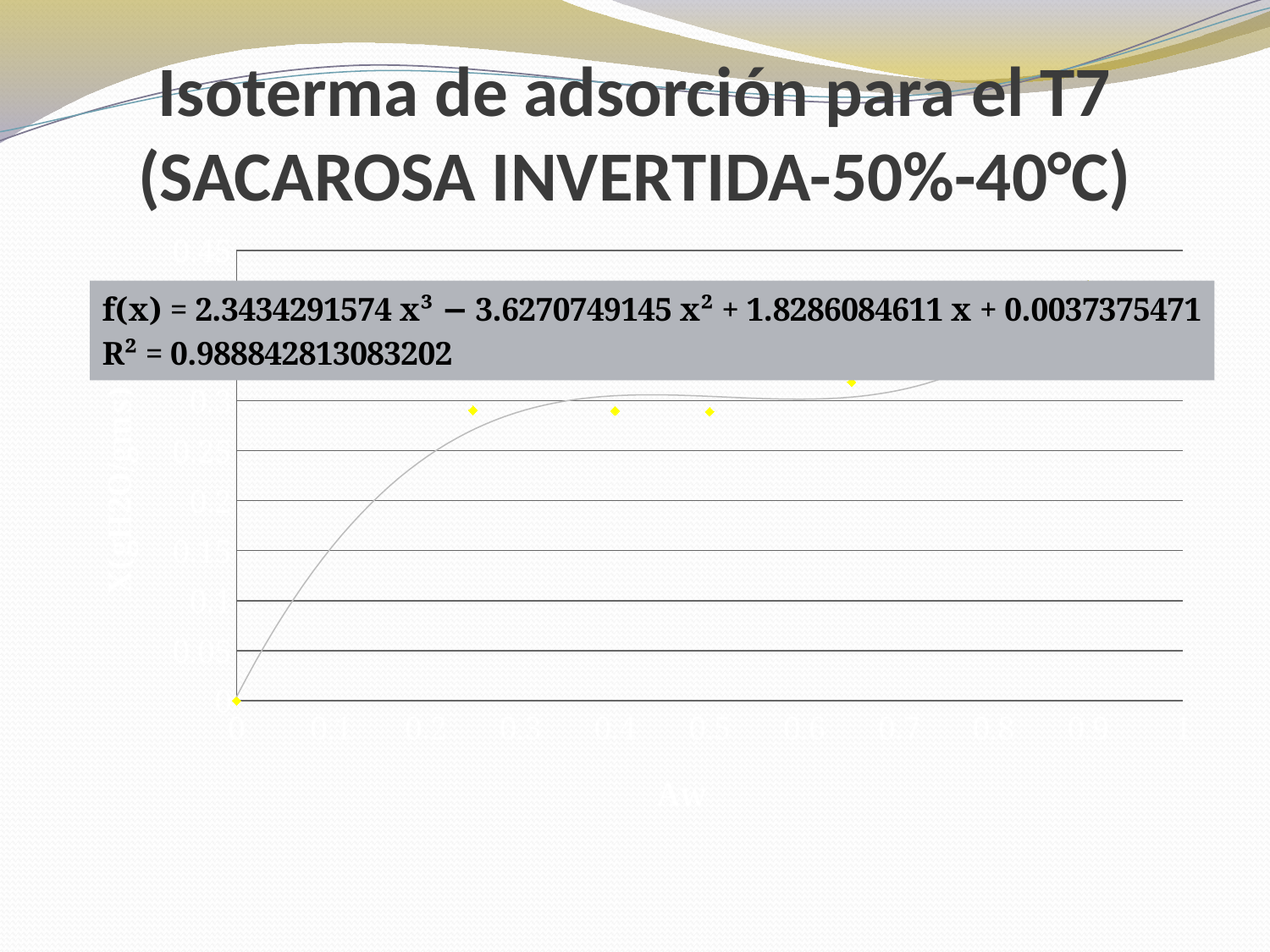
Is the plotted value at Aw of about 0.4 greater or less than 0.35? less Is the plotted value at Aw of about 0.65 greater or less than 0.4? less Is the plotted value at Aw of about 0.5 greater or less than 0.15? greater Do the plotted values generally rise or fall as Aw increases along the x axis? rise What kind of chart is shown on the slide? scatter chart At which Aw value is the lowest plotted point? 0 What is the plotted value at Aw = 0? 0 What R² value is printed on the chart? 0.988842813083202 What is the label of the x axis? Aw